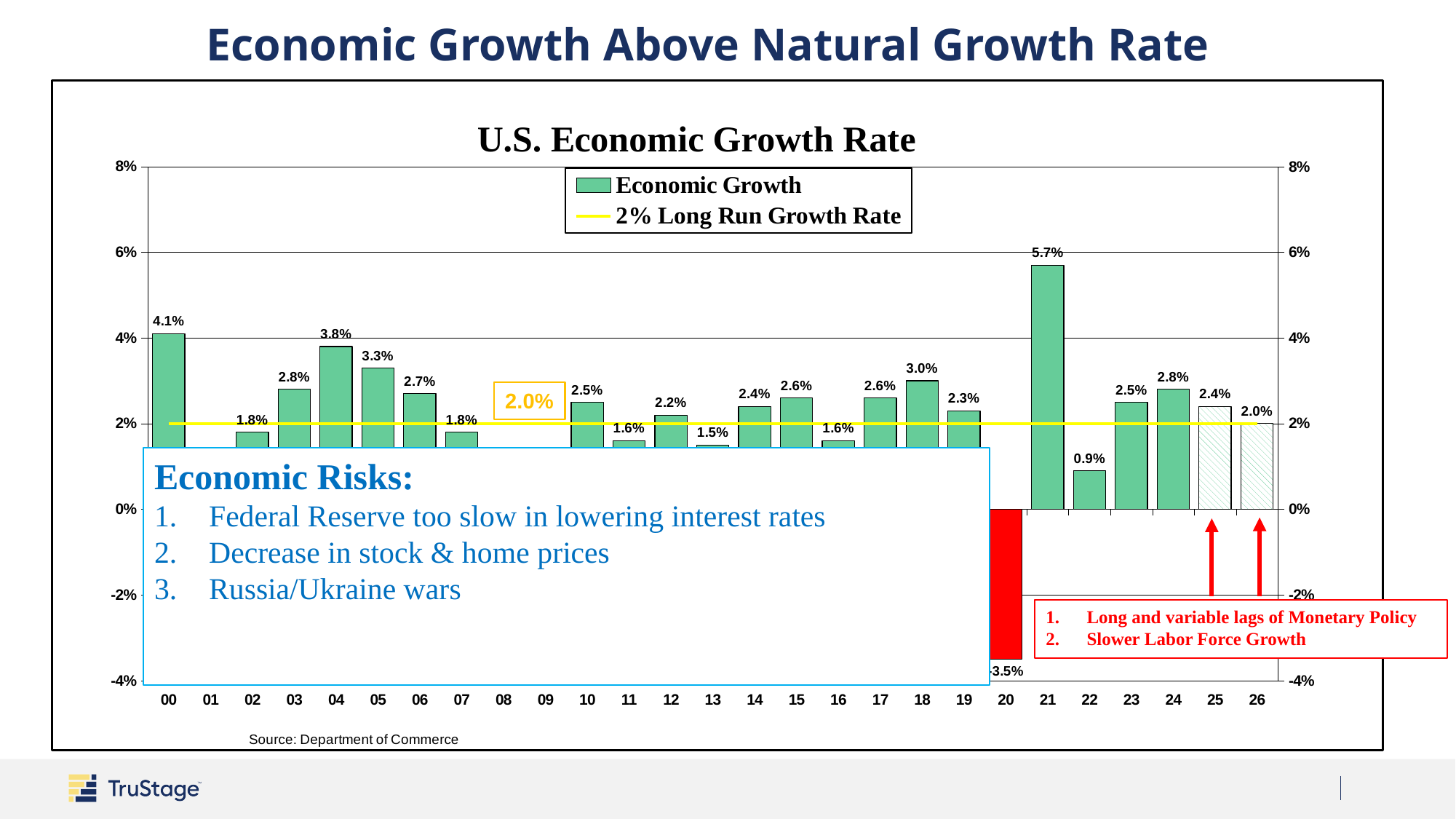
What kind of chart is used to show the economic growth rate? Bar chart Which year has the higher growth rate, 05 or 06? 05 Which year has the highest economic growth rate? 21 What is the economic growth rate shown for 22? 0.9% How many years are shown on the x axis? 27 Is the value for 21 greater or less than 4%? greater What is the economic growth rate shown for 21? 5.7% What is the difference between the growth rates for 18 and 19? 0.7 percentage points What is the economic growth rate shown for 04? 3.8% Which year has the lowest economic growth rate? 20 What is the economic growth rate shown for 26? 2.0% How many series does the legend list? 2